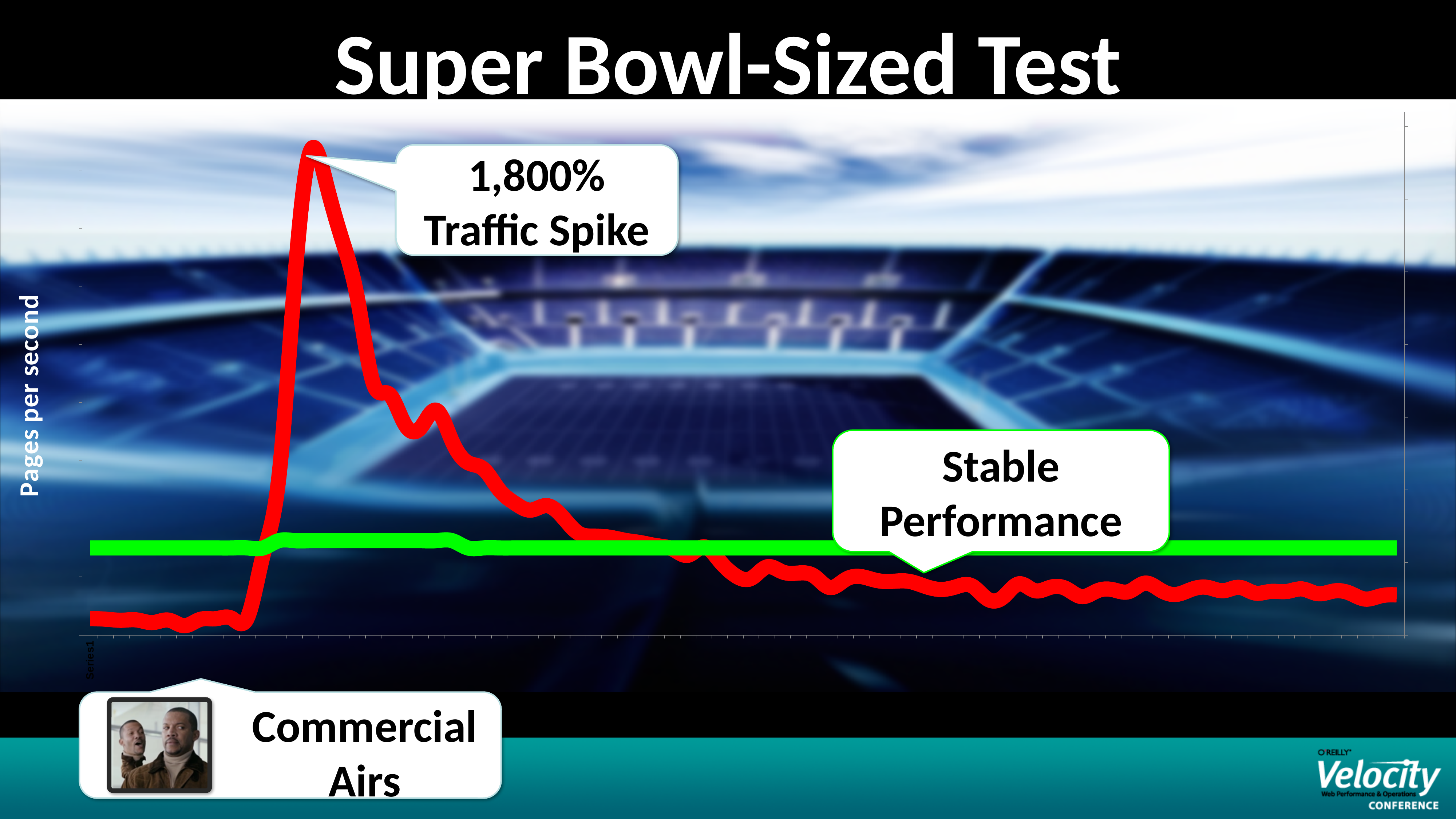
At its peak, is the red line higher or lower than the green line? higher After reaching its peak, does the red traffic line rise or fall as it moves to the right? fall According to the callout on the chart, how large is the traffic spike? 1,800% What does the callout pointing to the green line say? Stable Performance Before the spike, is the red line above or below the green line? below What colour is the line that shows the traffic spike? red How many lines are plotted on the chart? 2 What is the title of the slide containing the chart? Super Bowl-Sized Test Which line stays roughly flat across the whole chart, the red line or the green line? the green line What event does the callout at the bottom left of the chart mark? Commercial Airs What is the label on the vertical axis of the chart? Pages per second What kind of chart is shown on the slide? line chart